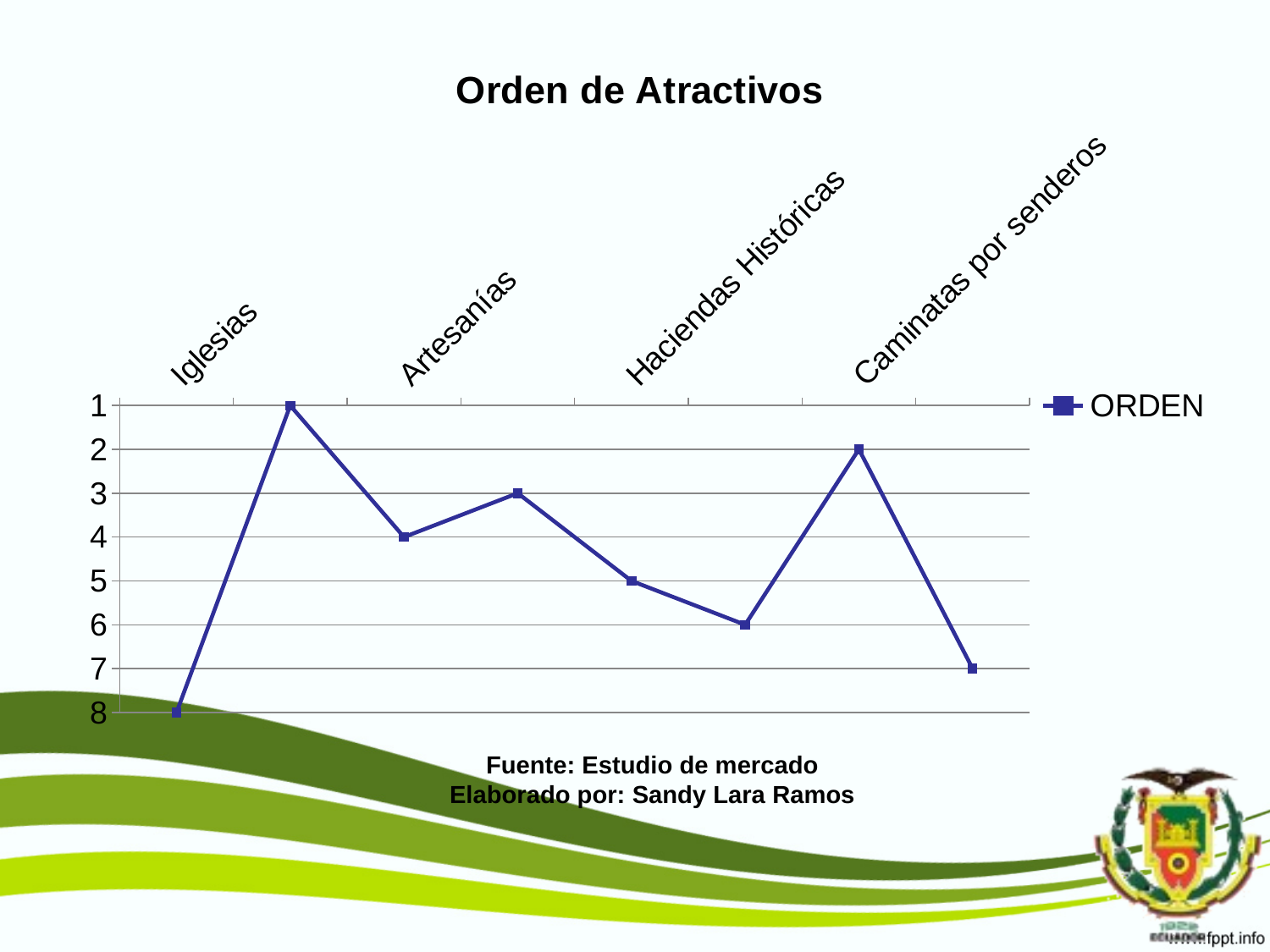
What is the value for Artesanías? 4 What is the value for Caminatas por senderos? 2 Which of the labeled categories has the largest value? Iglesias What type of chart is shown on the slide? line chart Which of the labeled categories has the smallest value? Caminatas por senderos How many data points are plotted on the line? 8 How many series does the legend list? 1 What is the value for Haciendas Históricas? 5 What is the difference between the values for Iglesias and Caminatas por senderos? 6 What is the value for Iglesias? 8 What is the name of the series shown in the legend? ORDEN What is the title of the chart? Orden de Atractivos